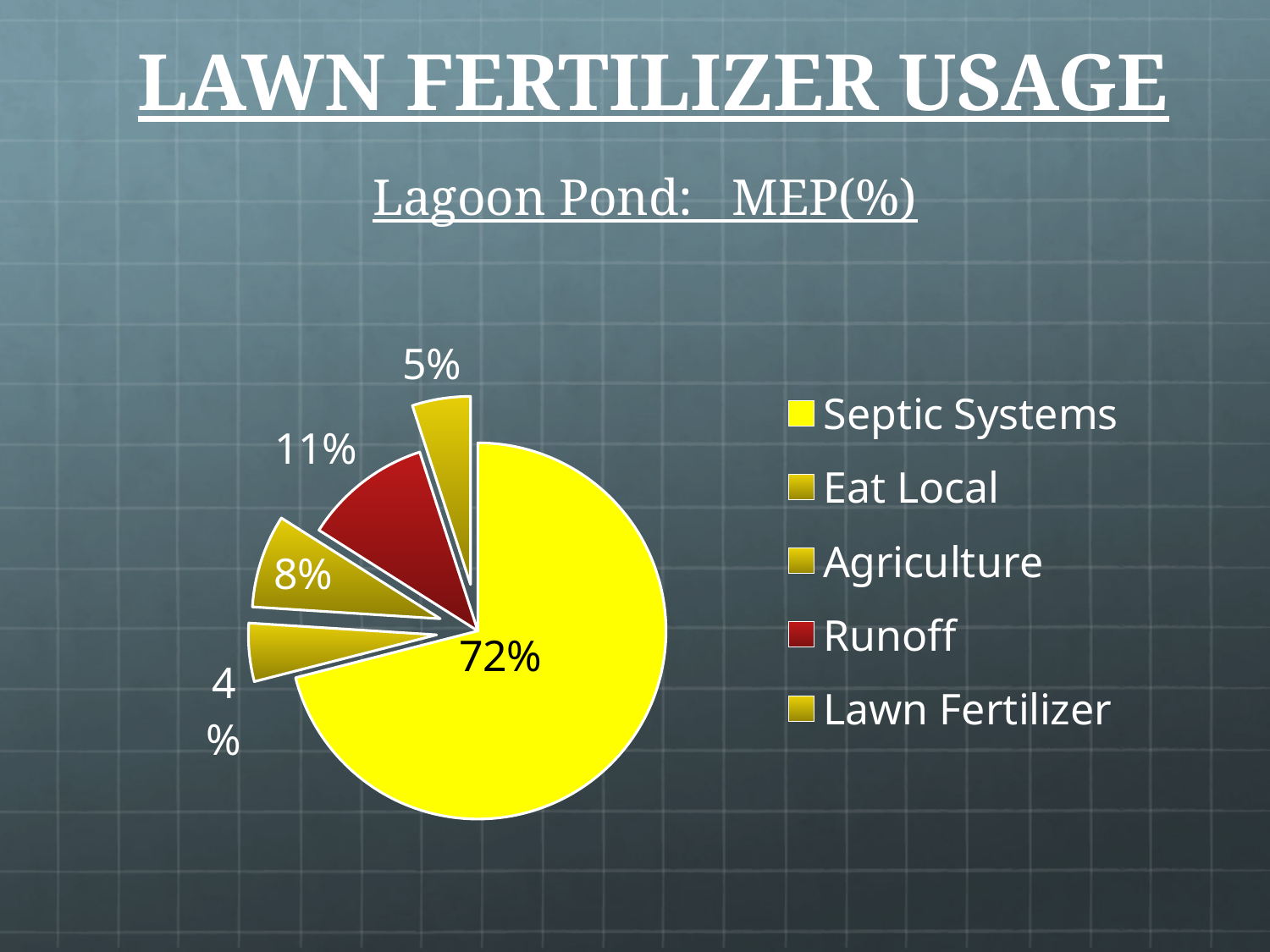
What kind of chart is shown on the slide? Pie chart What percentage is shown for Lawn Fertilizer? 5% Which category has the smallest slice of the pie? Eat Local What percentage is shown for Agriculture? 8% What percentage is shown for Runoff? 11% How many categories does the pie chart show? 5 How many percentage points larger is the Septic Systems slice than the Runoff slice? 61 What colour is the Runoff slice in the pie chart? Red What percentage is shown for Eat Local? 4% What share of the pie does Septic Systems account for? 72% Which is larger, the Agriculture slice or the Lawn Fertilizer slice? Agriculture Which category has the largest slice of the pie? Septic Systems